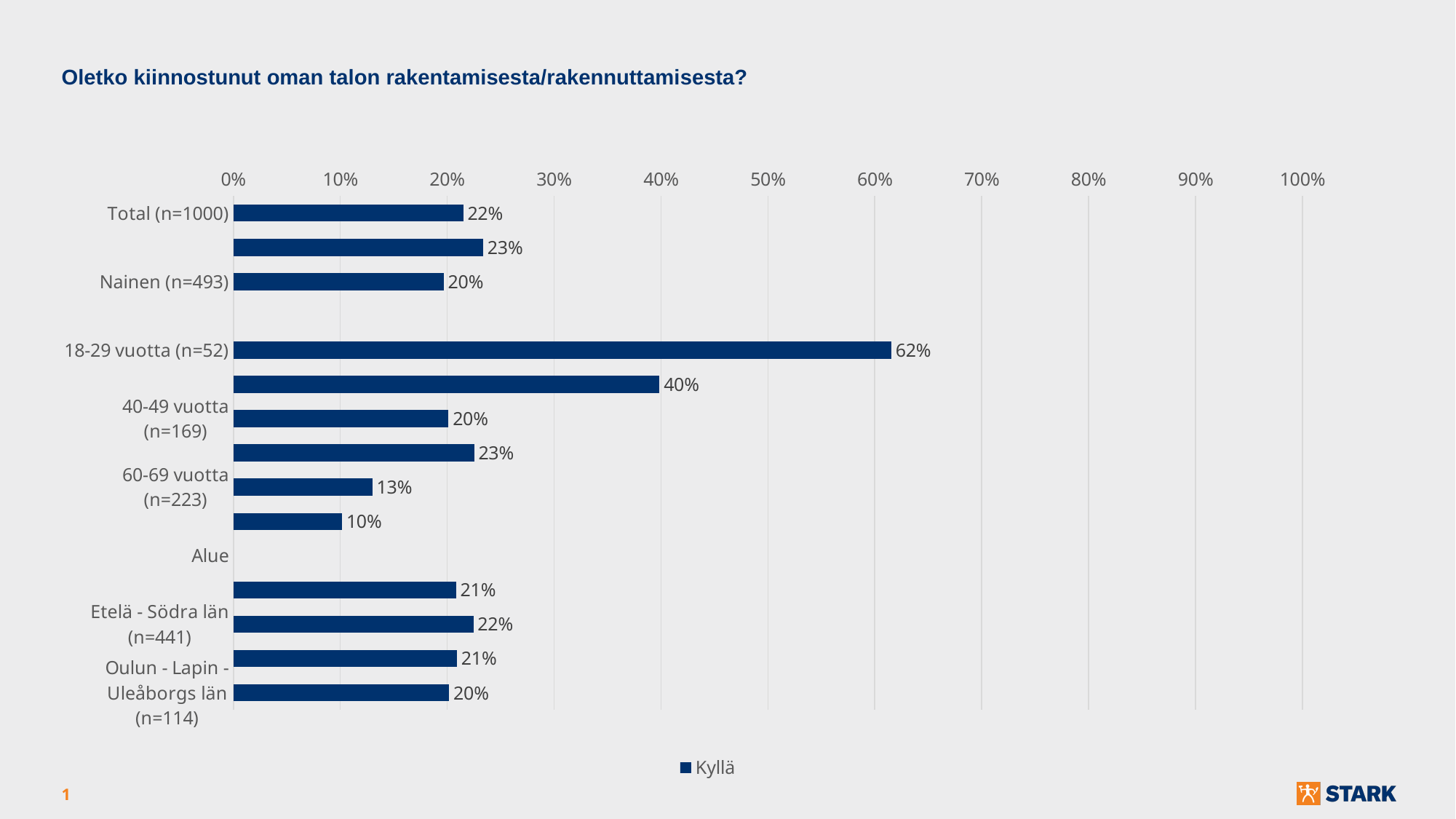
What is the value for Oulun - Lapin - Uleåborgs län (n=114)? 20% What is the value for Etelä - Södra län (n=441)? 22% Which category has the highest value? 18-29 vuotta (n=52) How many series does the legend list? 1 What kind of chart is shown on the slide? bar chart What is the difference between the values for 18-29 vuotta (n=52) and Total (n=1000)? 40 percentage points What is the value for Total (n=1000)? 22% Is the value for 40-49 vuotta (n=169) greater or less than 30%? less What is the value for Nainen (n=493)? 20% What is the value for 18-29 vuotta (n=52)? 62% Which is larger, the value for Total (n=1000) or the value for Nainen (n=493)? Total (n=1000) What is the value for 60-69 vuotta (n=223)? 13%